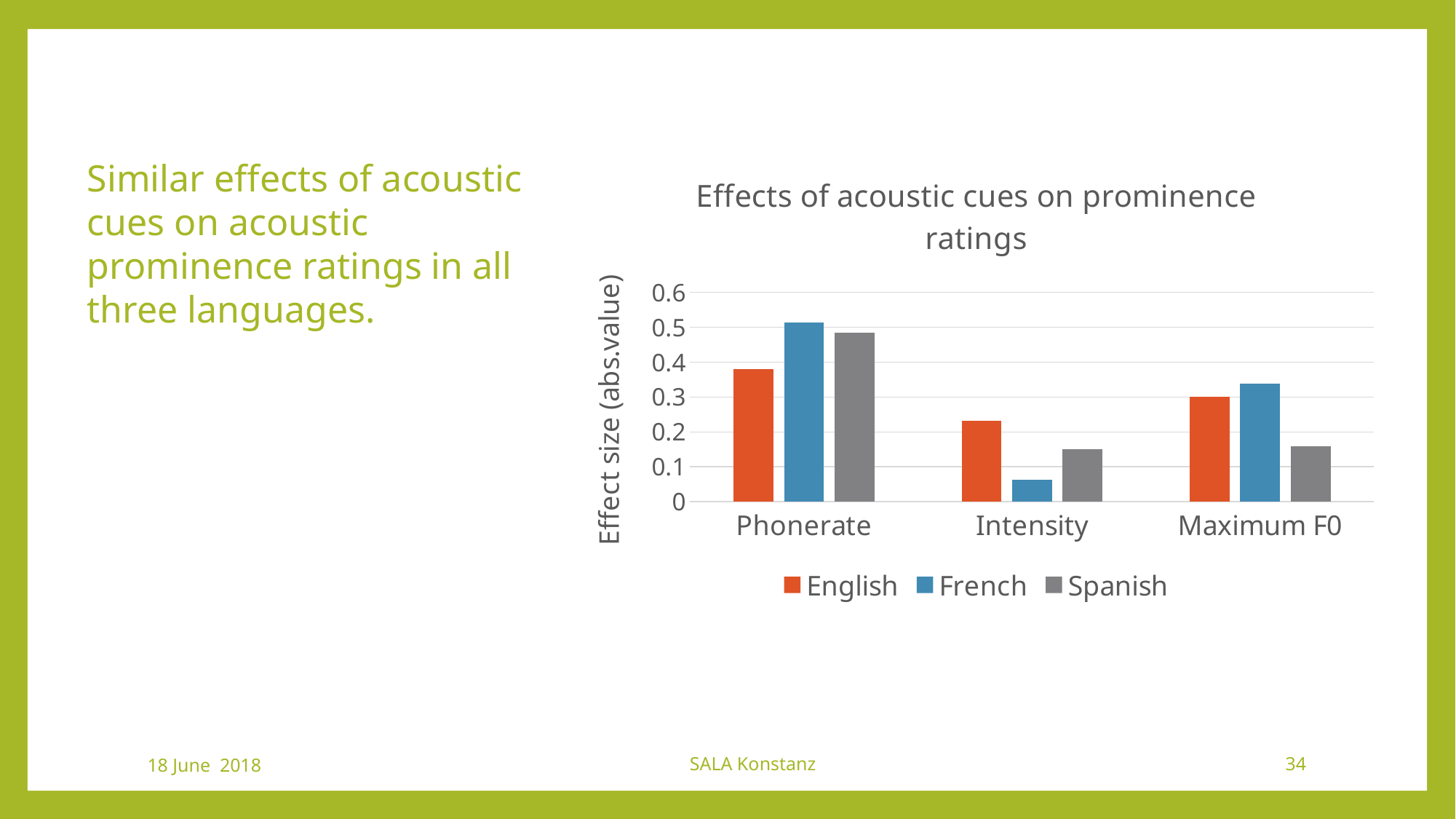
Is the French value for Phonerate greater or less than 0.5? greater Which language has the lowest effect size for Intensity? French Which language has the lowest effect size for Maximum F0? Spanish Which language has the highest effect size for Phonerate? French What is the y-axis label of the chart? Effect size (abs.value) What is the title of the chart? Effects of acoustic cues on prominence ratings Is the French value for Intensity greater or less than 0.1? less For Intensity, which is larger: the English value or the Spanish value? English How many series does the legend list? 3 What kind of chart is shown on the slide? bar chart How many categories are shown on the x axis? 3 Is the English value for Phonerate greater or less than 0.4? less